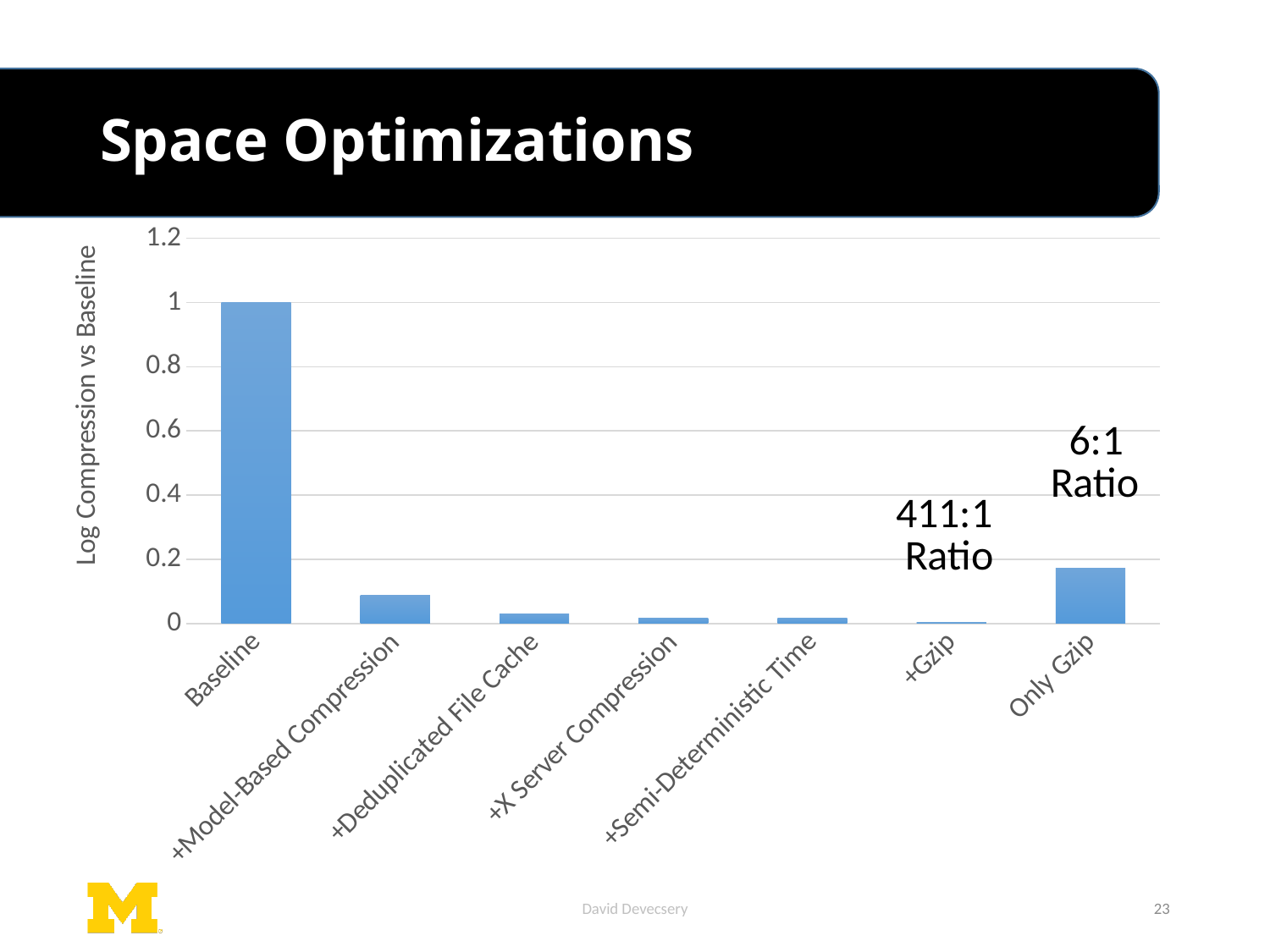
What is the label on the y axis? Log Compression vs Baseline Is the value for +Model-Based Compression greater or less than 0.2? less Which category has the highest value? Baseline What ratio is annotated above the +Gzip bar? 411:1 Ratio Which category has the lowest value? +Gzip What kind of chart is shown on the slide? bar chart Do the values rise or fall from Baseline through +Gzip along the x axis? fall How many categories are plotted on the x axis? 7 Which is larger, the value for Only Gzip or the value for +Gzip? Only Gzip Is the value for Baseline greater or less than 0.8? greater Which is larger, the value for +Model-Based Compression or the value for +Deduplicated File Cache? +Model-Based Compression What is the value for Baseline? 1